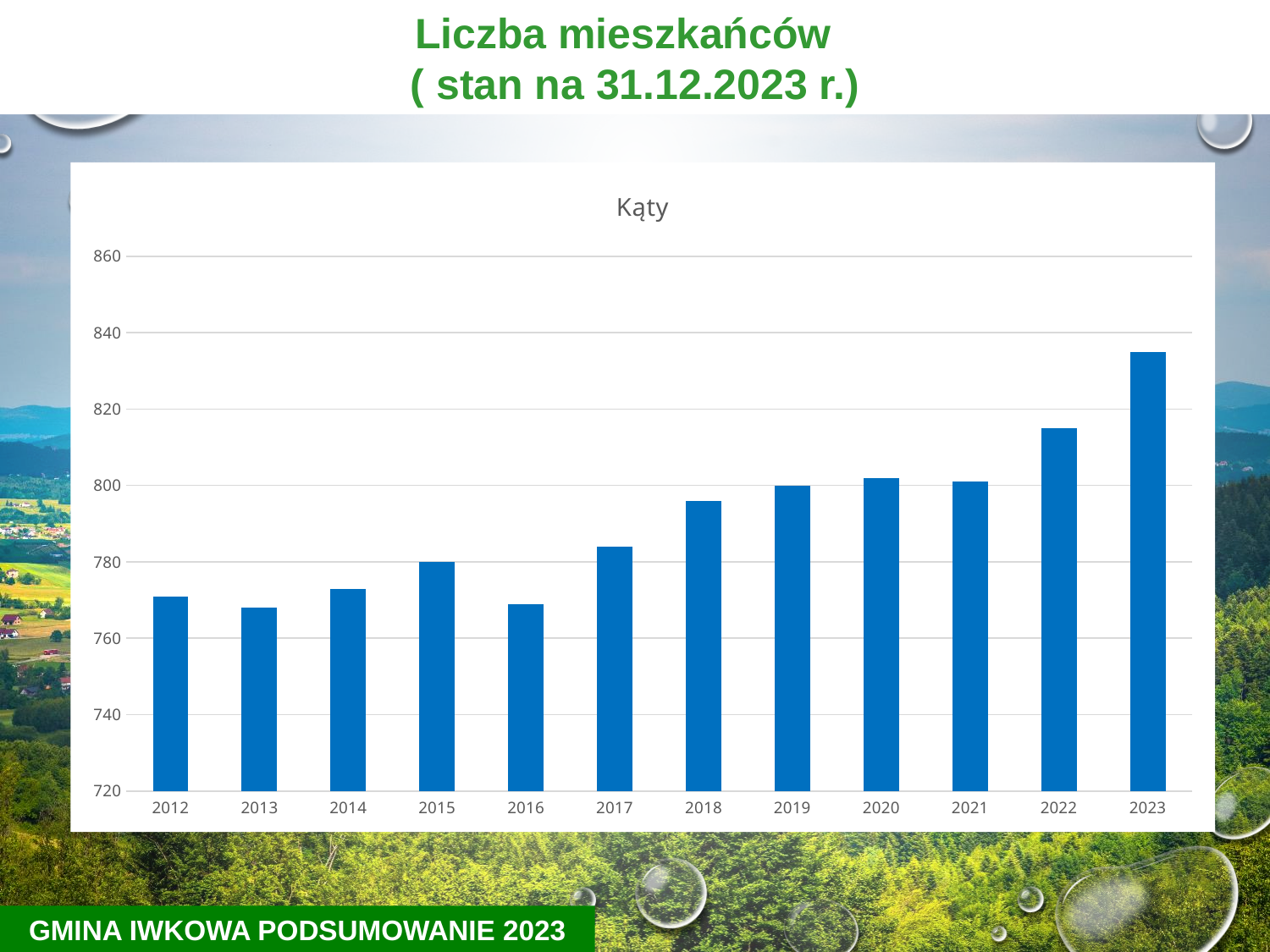
Is the value for 2013 greater or less than 780? less Which year has the larger value, 2012 or 2023? 2023 Do the values generally rise or fall from 2012 to 2023? rise What is the title of the chart? Kąty Is the value for 2012 greater or less than 760? greater Is the value for 2016 greater or less than 780? less Which year has the highest number of residents in the chart? 2023 What kind of chart is shown on the slide? bar chart How many years are shown on the x axis of the chart? 12 Which year has the larger value, 2018 or 2015? 2018